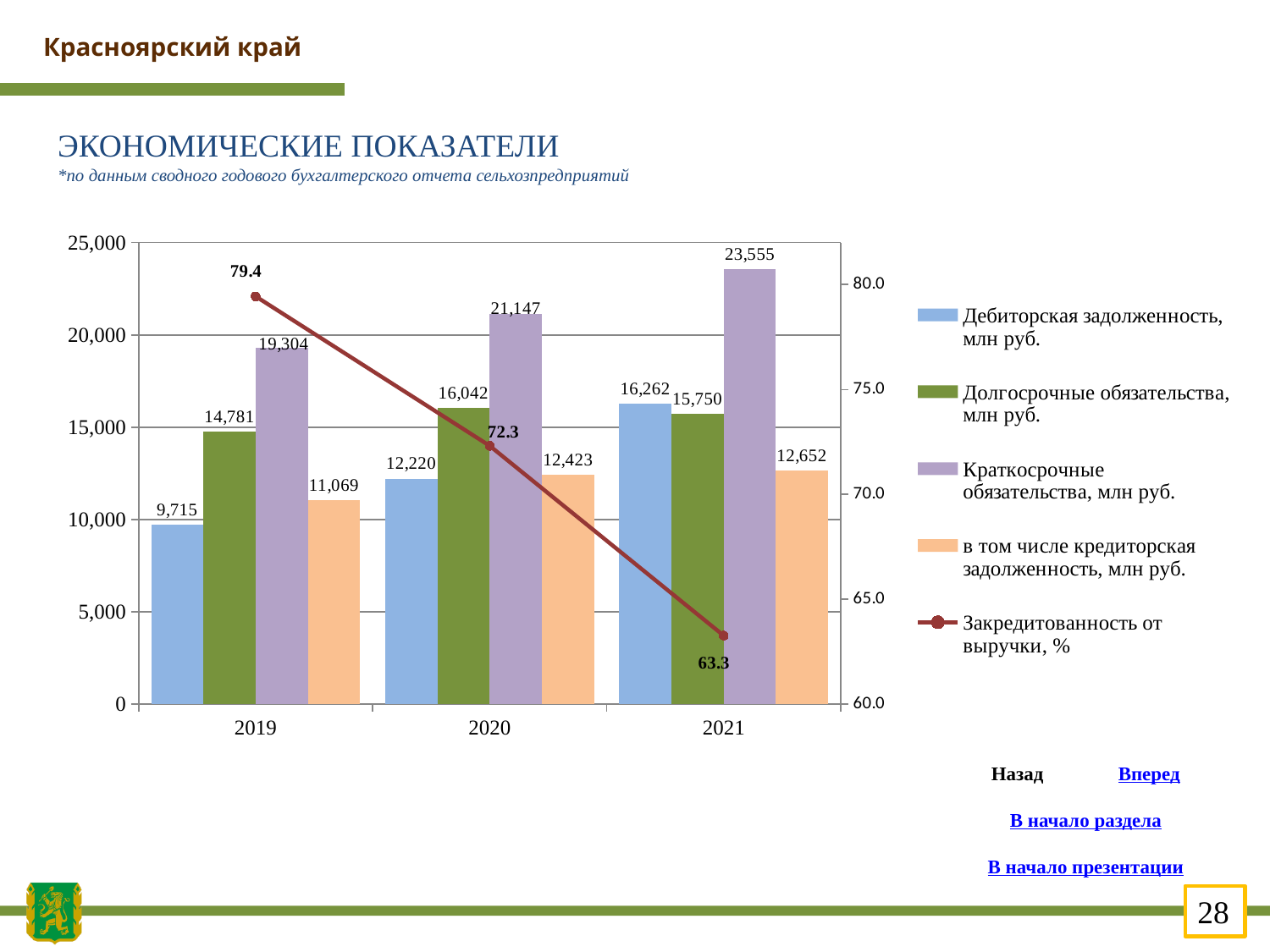
In which year is Закредитованность от выручки, % lowest? 2021 Is the value of Краткосрочные обязательства, млн руб. for 2020 greater or less than 20,000? greater Does Закредитованность от выручки, % rise or fall from 2019 to 2021? fall How many years are shown on the x axis of the chart? 3 What is the value of Дебиторская задолженность, млн руб. for 2019? 9,715 Which is larger in 2021: Дебиторская задолженность, млн руб. or Долгосрочные обязательства, млн руб.? Дебиторская задолженность, млн руб. What is the value of Краткосрочные обязательства, млн руб. for 2021? 23,555 What is the difference between Краткосрочные обязательства, млн руб. in 2021 and in 2019? 4,251 In which year is Долгосрочные обязательства, млн руб. highest? 2020 What is the value of Закредитованность от выручки, % for 2020? 72.3 What is the value of в том числе кредиторская задолженность, млн руб. for 2020? 12,423 How many series does the chart legend list? 5